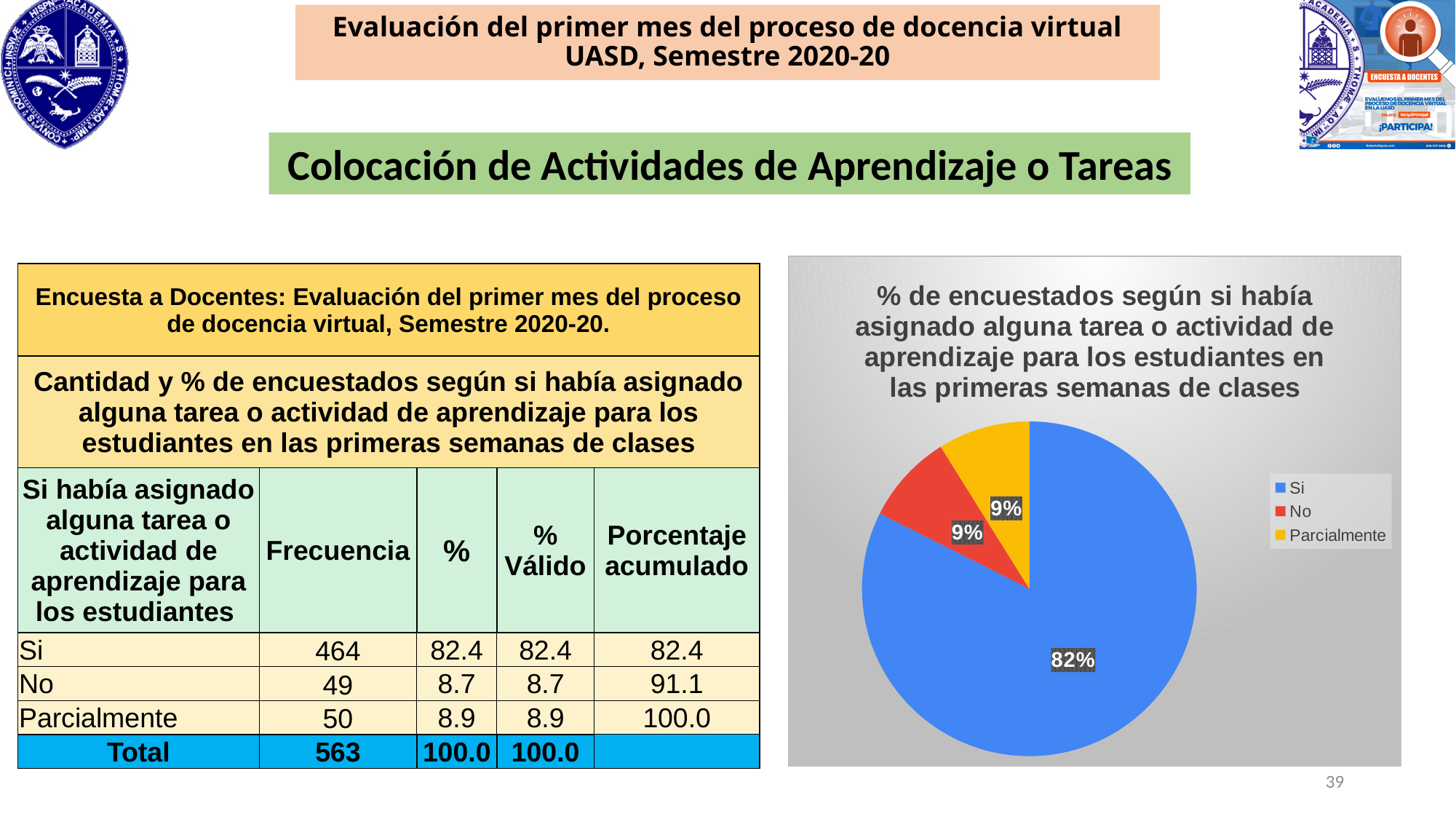
Which slice is larger in the pie chart, "Si" or "No"? Si What colour is the "Si" slice in the pie chart? blue How many entries does the pie chart's legend list? 3 What is the value shown for the "No" slice in the pie chart? 9% What percentage of the pie chart does the "Si" slice represent? 82% What is the value shown for the "Parcialmente" slice in the pie chart? 9% How many slices does the pie chart have? 3 What kind of chart is shown on the slide? pie chart Which category has the largest slice in the pie chart? Si What colour is the "Parcialmente" slice in the pie chart? yellow What is the difference in percentage points between the "Si" slice and the "No" slice in the pie chart? 73%